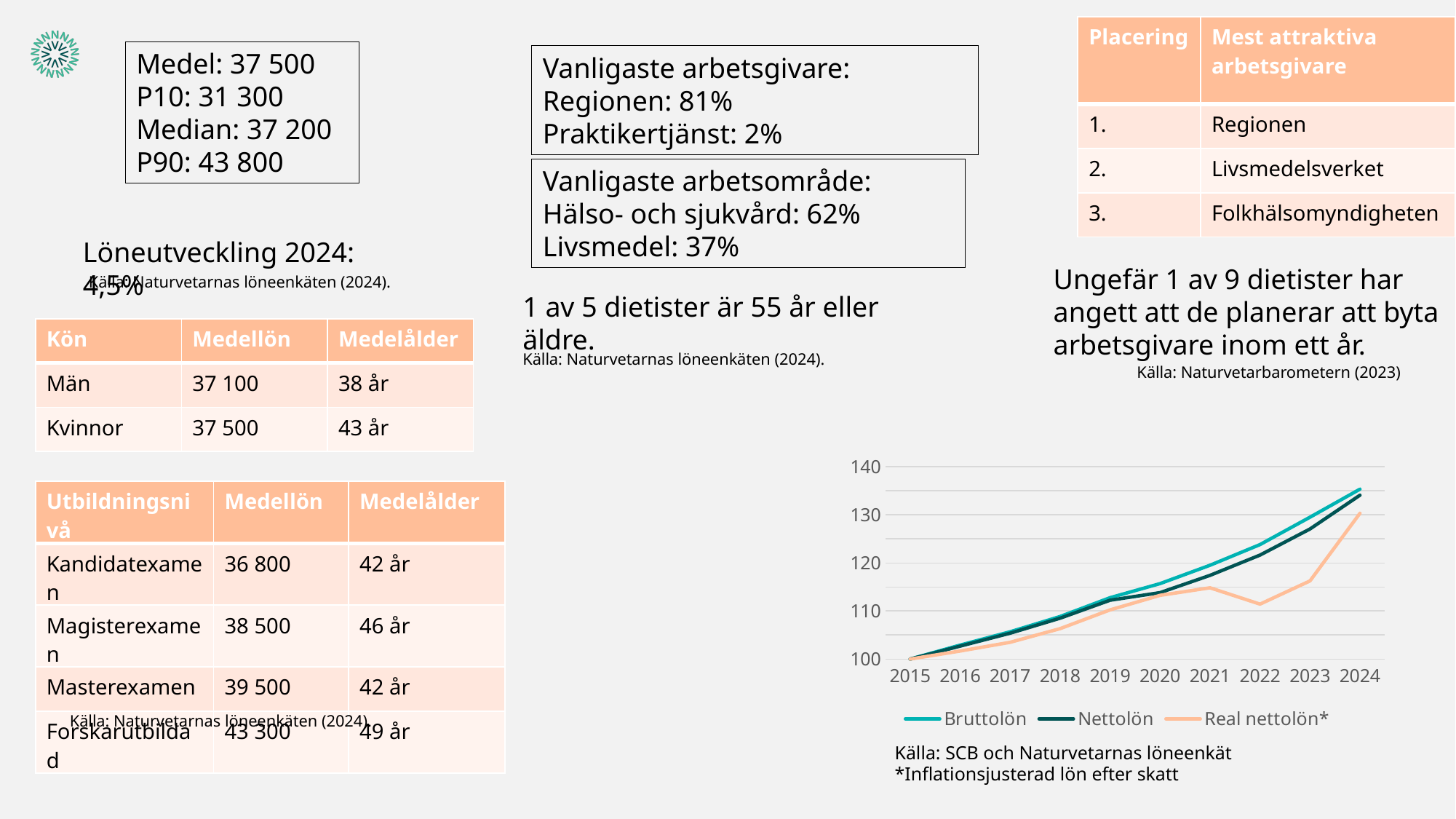
What kind of chart is shown at the bottom right of the slide? line chart Which series has the lowest value in 2024 in the line chart? Real nettolön* Which series in the line chart is drawn in the light orange colour? Real nettolön* How many years are shown on the x axis of the line chart? 10 Does the Bruttolön line rise or fall from 2015 to 2024? rise Does the Real nettolön* line rise or fall between 2021 and 2022? fall Is the value for Bruttolön in 2024 greater or less than 130? greater Is the value for Real nettolön* in 2022 greater or less than 120? less In which year does the Bruttolön line reach its highest value? 2024 What is the first year shown on the x axis of the line chart? 2015 How many series does the legend of the line chart list? 3 In 2022, which is larger in the line chart: Nettolön or Real nettolön*? Nettolön